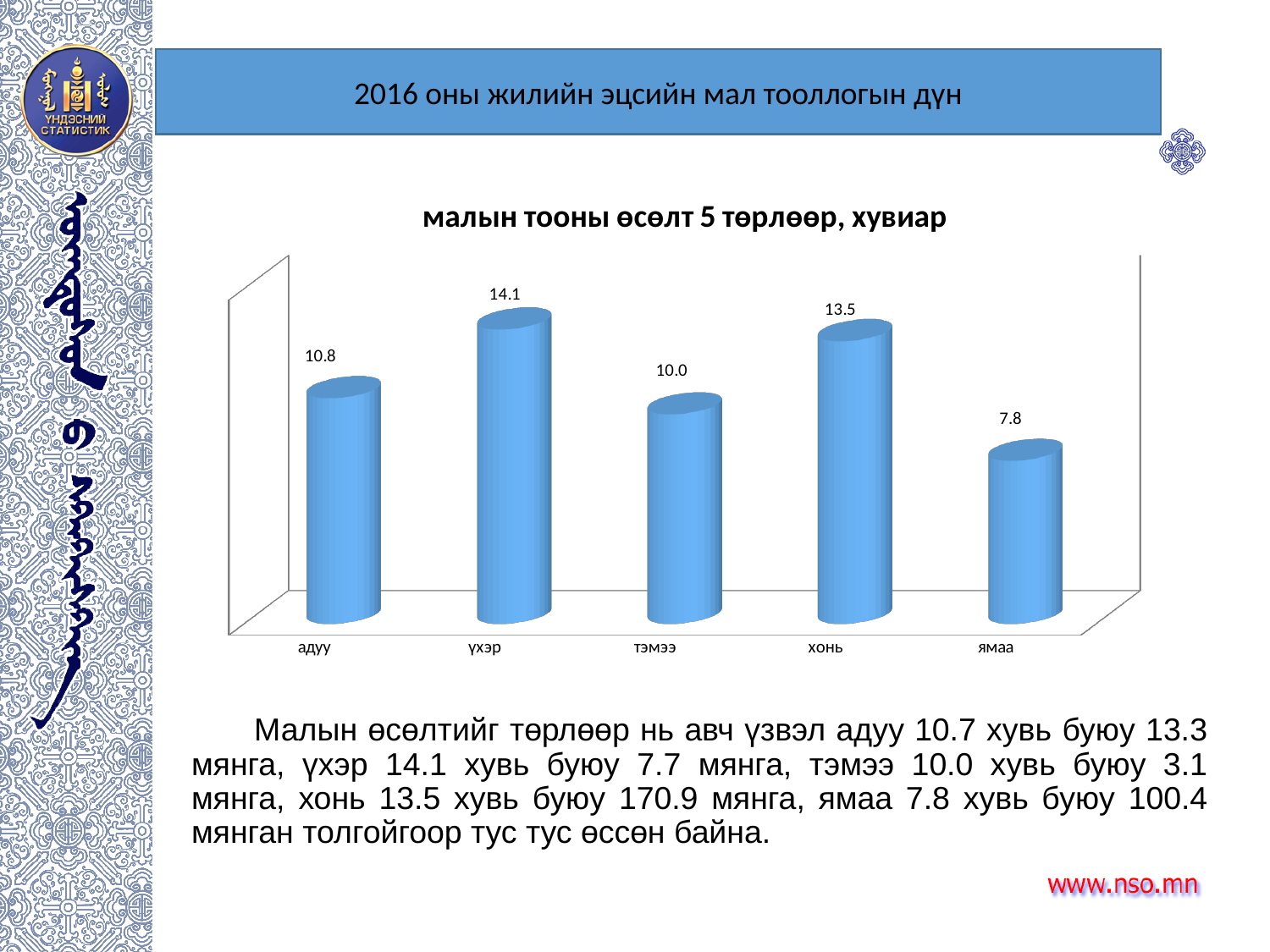
What is the value for ямаа? 7.8 What is the difference between the values for үхэр and ямаа? 6.3 What is the value for тэмээ? 10.0 Which category has the lowest value? ямаа What is the value for үхэр? 14.1 What kind of chart is shown on the slide? bar chart What is the value for хонь? 13.5 What is the value for адуу? 10.8 How many categories are shown in the chart? 5 Which is larger, the value for хонь or the value for адуу? хонь Which category has the highest value? үхэр What is the title of the chart? малын тооны өсөлт 5 төрлөөр, хувиар